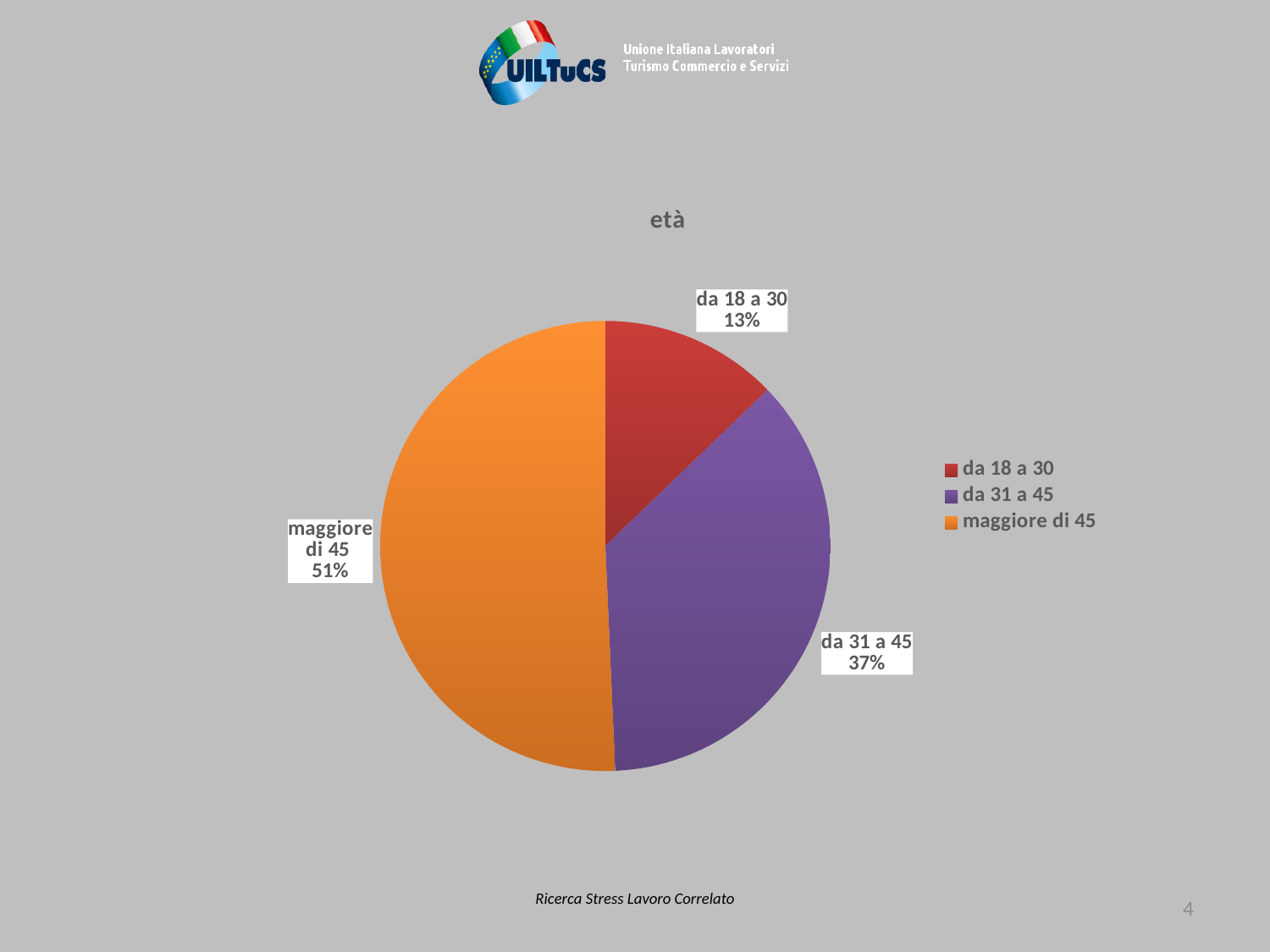
What is the title of the chart? età How many entries does the legend list? 3 How many slices does the pie chart have? 3 Which slice is larger, 'da 18 a 30' or 'da 31 a 45'? da 31 a 45 Which category has the largest slice of the pie? maggiore di 45 What type of chart is shown on the slide? pie chart Which category has the smallest slice of the pie? da 18 a 30 What colour is the 'maggiore di 45' slice? orange What share of the pie does the 'da 31 a 45' slice represent? 37% What share of the pie does the 'da 18 a 30' slice represent? 13% What is the difference in percentage points between the 'maggiore di 45' slice and the 'da 31 a 45' slice? 14% What share of the pie does the 'maggiore di 45' slice represent? 51%